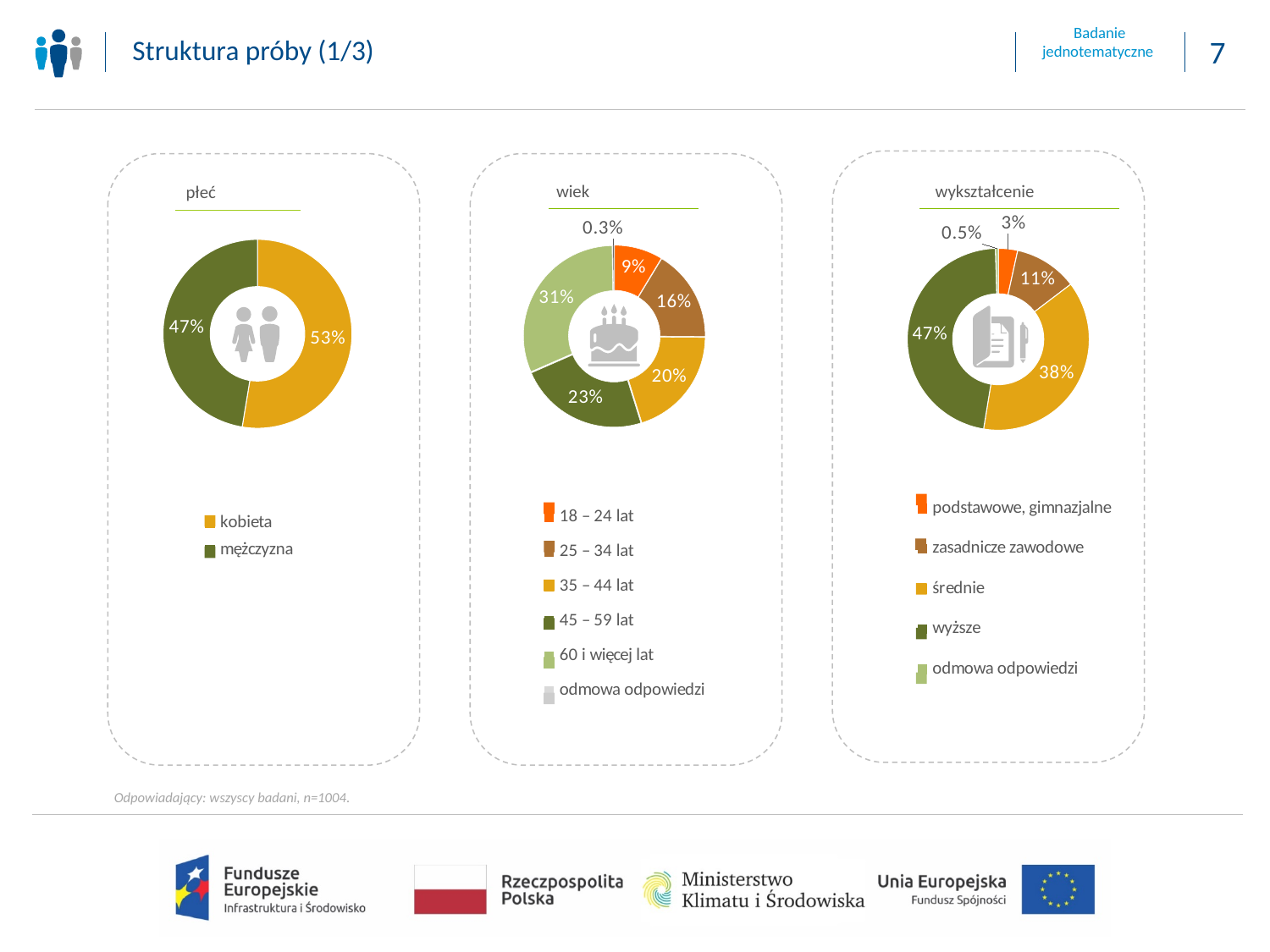
In the 'wykształcenie' chart, what share is labelled for średnie? 38% In the 'płeć' chart, what share is labelled for mężczyzna? 47% In the 'wiek' chart, how many categories does the legend list? 6 In the 'wiek' chart, which age group has the largest share? 60 i więcej lat What kind of chart is used for 'płeć'? Pie (donut) chart In the 'wiek' chart, which is larger: the share for 25 – 34 lat or for 45 – 59 lat? 45 – 59 lat In the 'wykształcenie' chart, which category has the largest share? wyższe In the 'wiek' chart, which category has the smallest share? odmowa odpowiedzi In the 'wykształcenie' chart, what is the difference between the wyższe and zasadnicze zawodowe shares? 36% In the 'płeć' chart, what share is labelled for kobieta? 53% In the 'płeć' chart, what is the difference between the kobieta and mężczyzna shares? 6% In the 'wiek' chart, what share is labelled for 35 – 44 lat? 20%